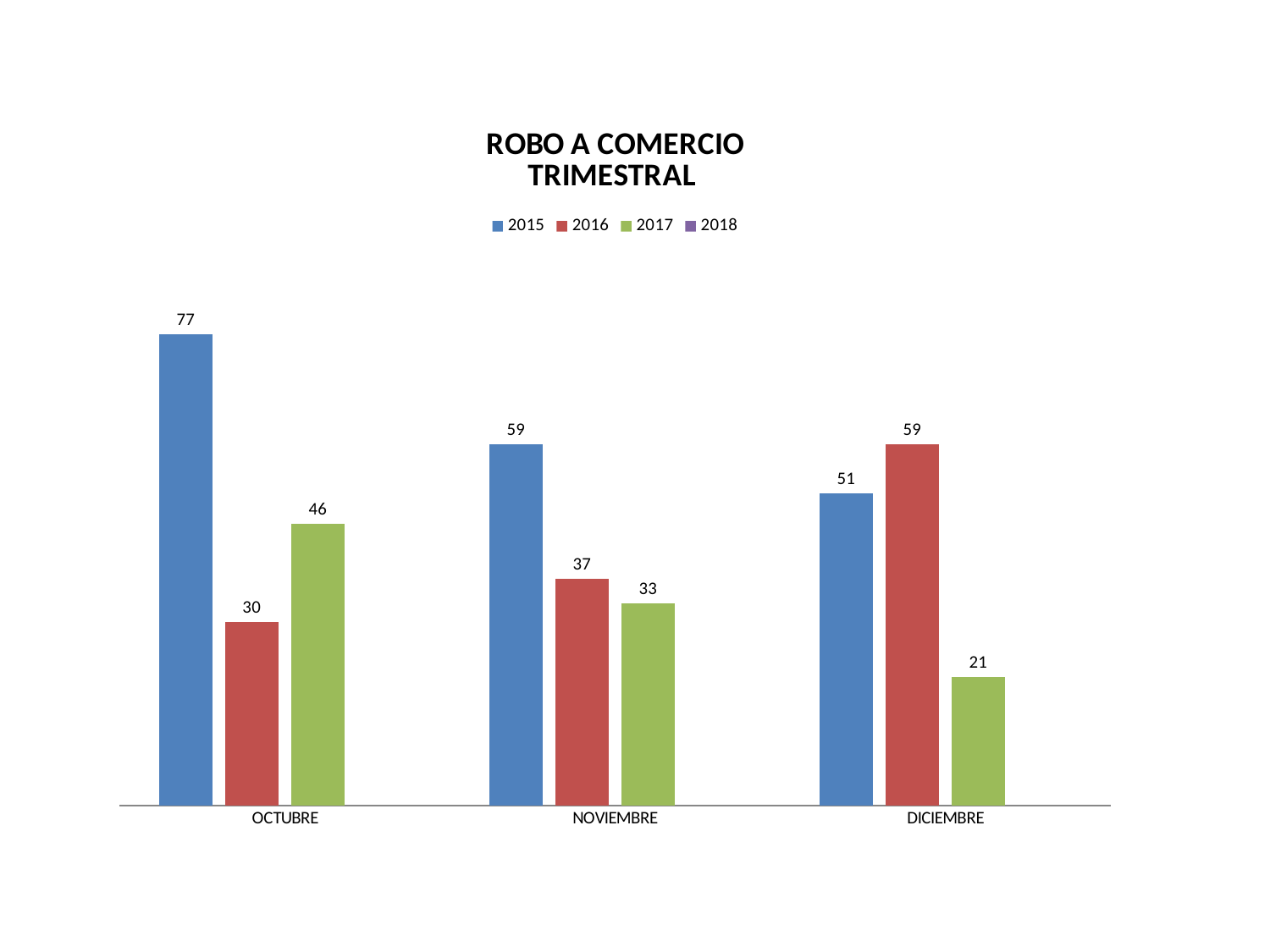
How many months are shown on the x axis? 3 How many series does the legend list? 4 Which is larger in DICIEMBRE, the value for 2015 or the value for 2016? 2016 What is the difference between the 2015 and 2016 values in OCTUBRE? 47 What is the value for 2015 in OCTUBRE? 77 What is the title of the chart? ROBO A COMERCIO TRIMESTRAL What is the value for 2016 in NOVIEMBRE? 37 Which month has the highest value for 2015? OCTUBRE What kind of chart is shown on the slide? Bar chart Which month has the lowest value for 2017? DICIEMBRE Do the values for 2017 rise or fall from OCTUBRE to DICIEMBRE? Fall What is the value for 2017 in DICIEMBRE? 21